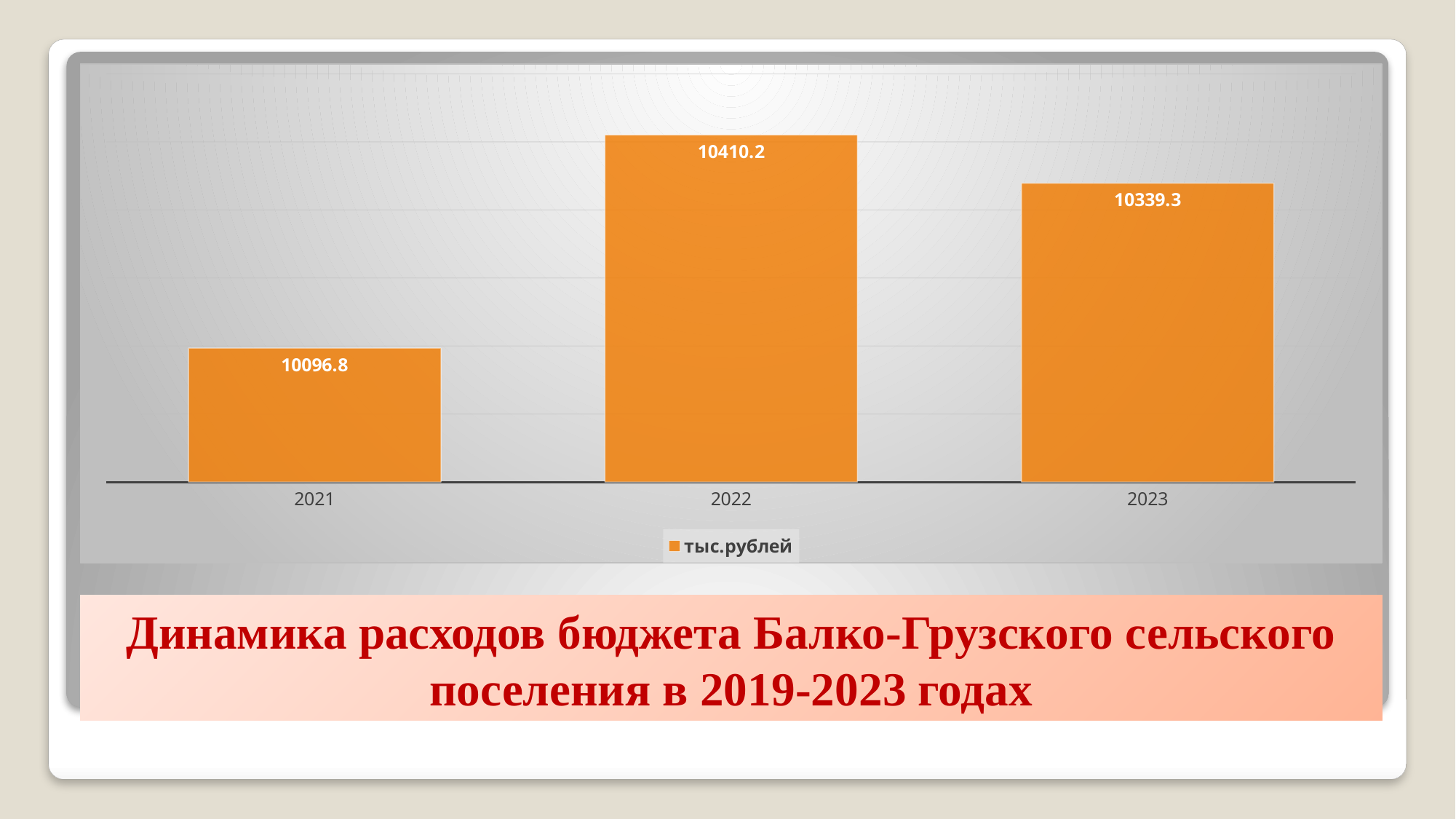
What is the value for 2023? 10339.3 What is the difference between the values for 2022 and 2023? 70.9 What is the value for 2022? 10410.2 What is the difference between the values for 2022 and 2021? 313.4 What is the value for 2021? 10096.8 How many years are shown on the x axis? 3 How many series does the legend list? 1 Which year has the highest value? 2022 Which is larger, the value for 2023 or the value for 2021? 2023 Which year has the lowest value? 2021 What kind of chart is shown on the slide? bar chart What is the legend entry for the series? тыс.рублей